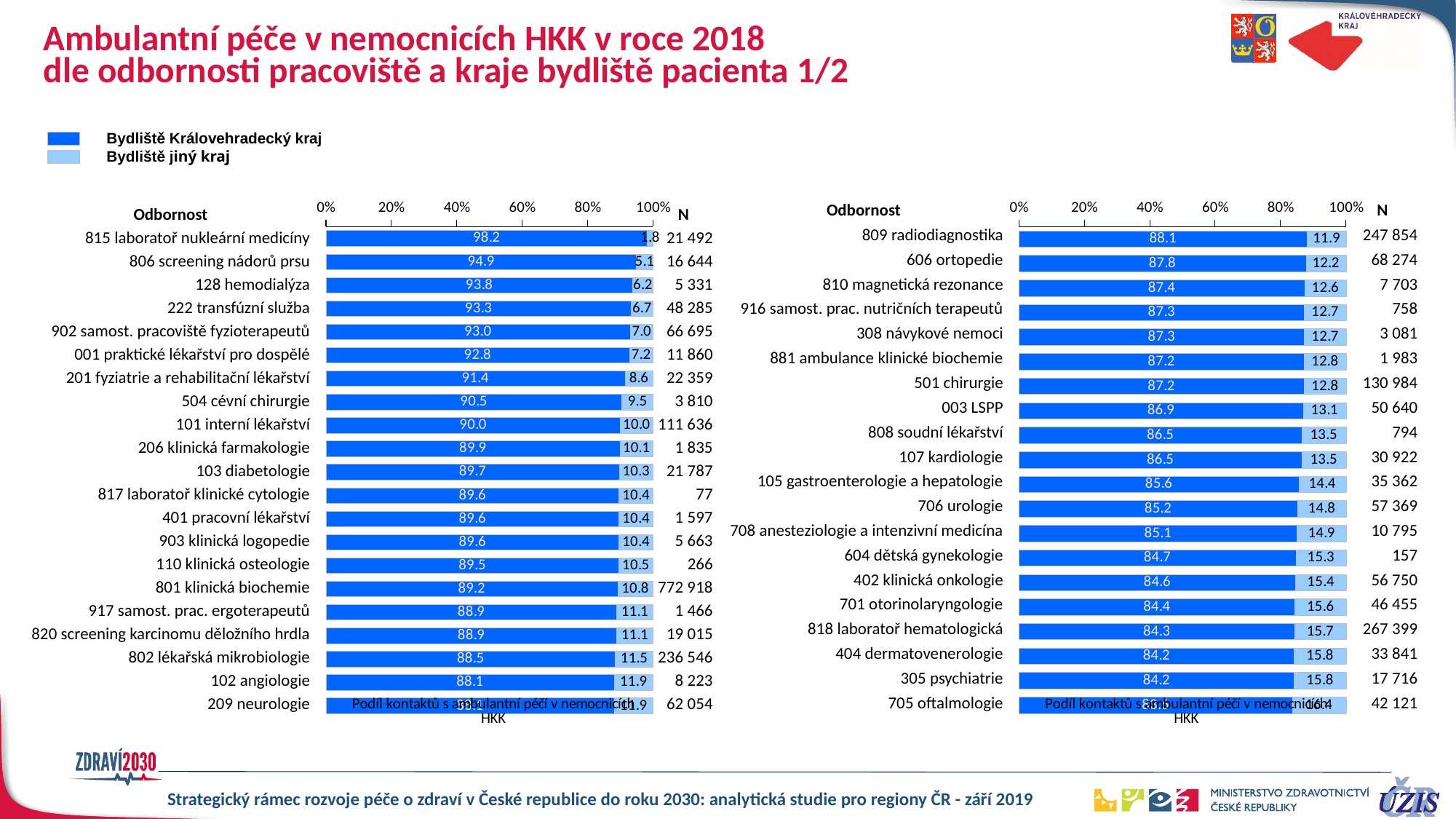
In the left chart, what is the share of contacts for patients from Královehradecký kraj for 815 laboratoř nukleární medicíny? 98.2 How many series does the legend list? 2 How many specialties are listed in the right chart? 20 In the right chart, what is the share of contacts for patients from another region (Bydliště jiný kraj) for 305 psychiatrie? 15.8 In the right chart, which has a larger share of patients from another region: 501 chirurgie or 604 dětská gynekologie? 604 dětská gynekologie In the left chart, which specialty has the highest share of patients from Královehradecký kraj? 815 laboratoř nukleární medicíny In the right chart, which specialty has the highest share of patients from Královehradecký kraj? 809 radiodiagnostika In the left chart, is the Královehradecký kraj share for 101 interní lékařství greater or less than 80%? greater In the right chart, what is the N value for 809 radiodiagnostika? 247 854 In the left chart, what is the difference between the Královehradecký kraj shares of 815 laboratoř nukleární medicíny and 806 screening nádorů prsu? 3.3 In the left chart, what is the N value for 801 klinická biochemie? 772 918 What type of chart is used on this slide? Stacked bar chart